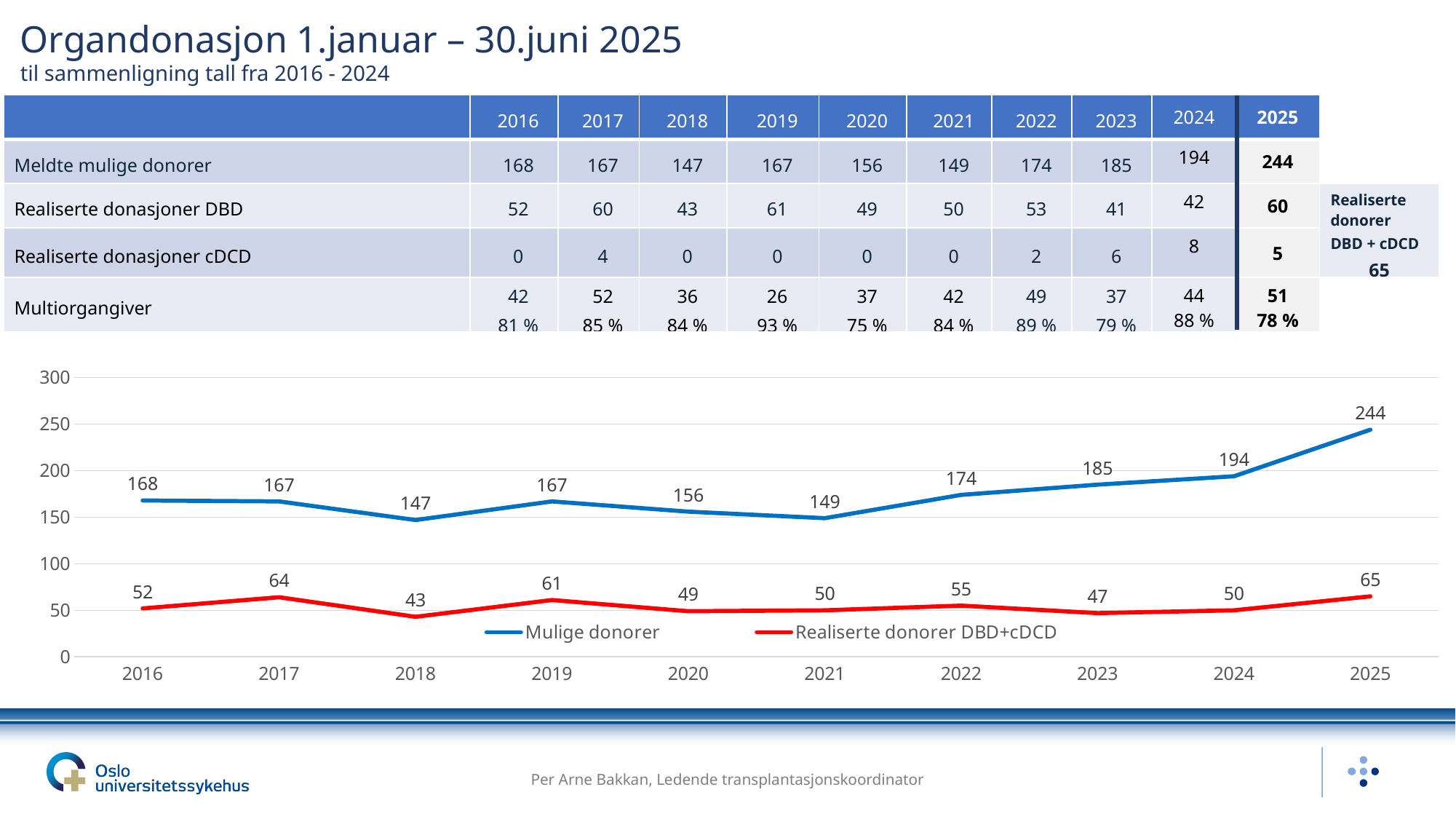
Is the value for Mulige donorer in 2021 greater or less than 150? less Which year has the lowest value for Realiserte donorer DBD+cDCD? 2018 What is the value for Mulige donorer in 2018? 147 Which colour is the Realiserte donorer DBD+cDCD line? red What is the value for Realiserte donorer DBD+cDCD in 2017? 64 How many years are shown on the x axis of the chart? 10 Which year has the highest value for Mulige donorer? 2025 What is the difference between Mulige donorer in 2025 and in 2024? 50 How many series does the chart legend list? 2 What is the value for Mulige donorer in 2025? 244 What kind of chart is shown on the slide? line chart Which is larger: Realiserte donorer DBD+cDCD in 2019 or in 2022? 2019